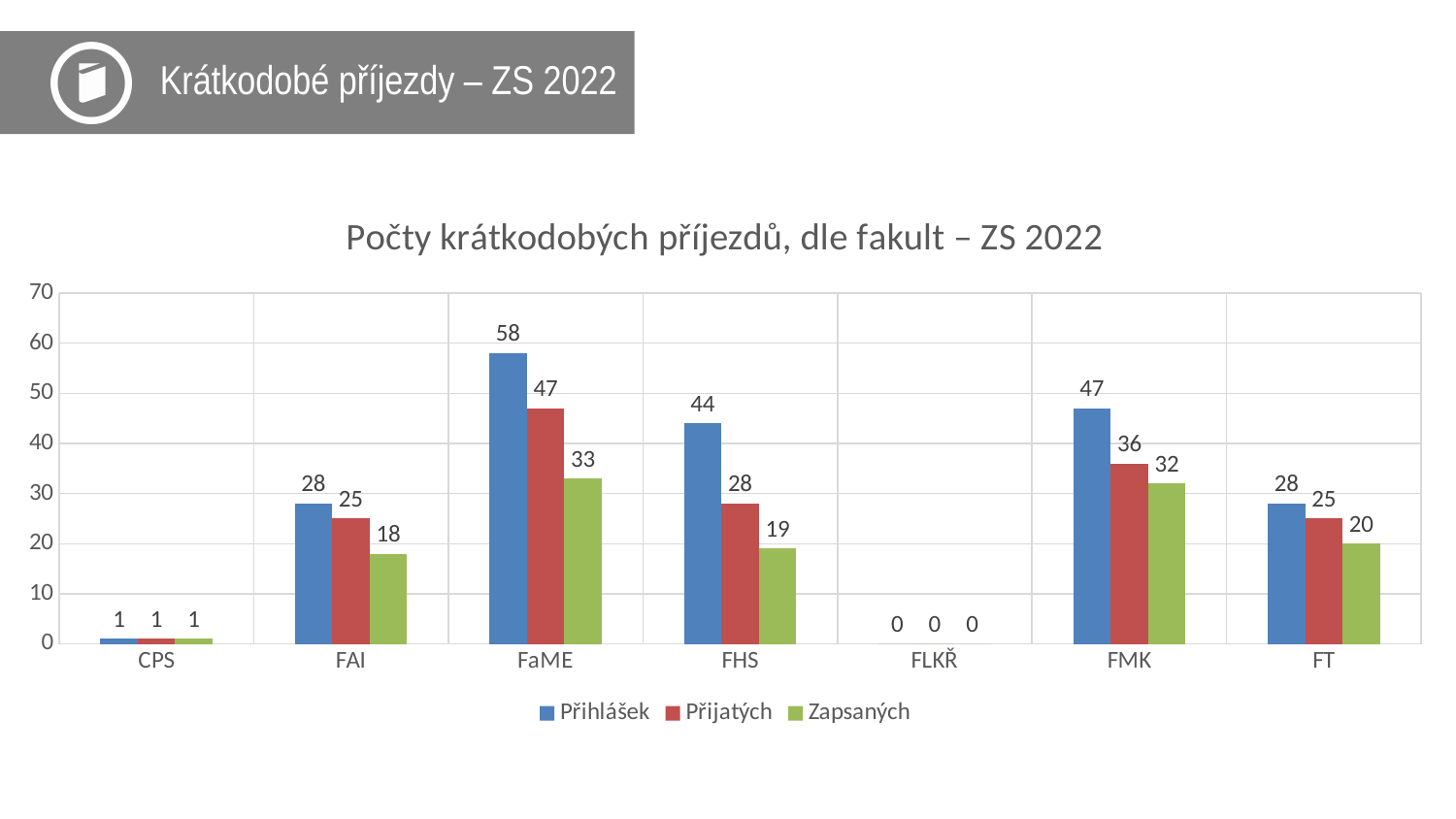
How many faculties are shown on the x axis? 7 What is the title of the chart? Počty krátkodobých příjezdů, dle fakult – ZS 2022 What is the Přijatých value for FHS? 28 What kind of chart is shown? bar chart How many series does the legend list? 3 Which series is shown in green? Zapsaných What is the Přihlášek value for FaME? 58 What is the Zapsaných value for FMK? 32 Which faculty has the lowest Zapsaných value? FLKŘ Which faculty has the highest Přihlášek value? FaME What is the difference between the Přihlášek and Zapsaných values for FaME? 25 Which is larger, the Přijatých value for FMK or the Přijatých value for FHS? FMK